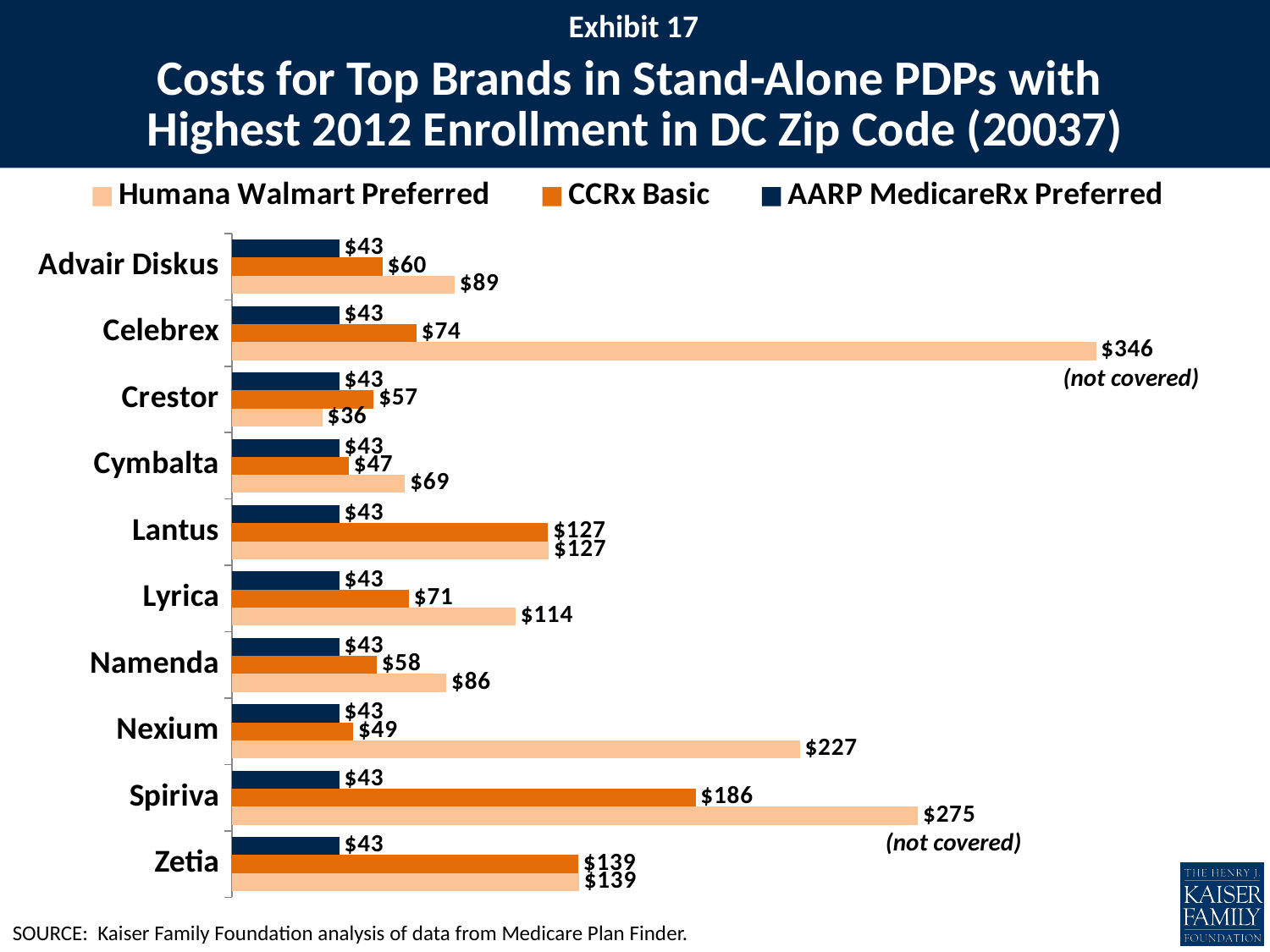
Which is larger for Crestor: the CCRx Basic cost or the Humana Walmart Preferred cost? CCRx Basic What is the AARP MedicareRx Preferred cost for Lantus? $43 Which brand has the lowest CCRx Basic cost? Cymbalta How many series does the legend list? 3 Which brand has the highest Humana Walmart Preferred cost? Celebrex Which two brands are marked as not covered by Humana Walmart Preferred? Celebrex and Spiriva What is the difference between the Humana Walmart Preferred and CCRx Basic costs for Nexium? $178 How many brands are shown on the chart? 10 What is the CCRx Basic cost for Spiriva? $186 What kind of chart is shown on the slide? Bar chart Which brand has the lowest Humana Walmart Preferred cost? Crestor What is the Humana Walmart Preferred cost for Celebrex? $346